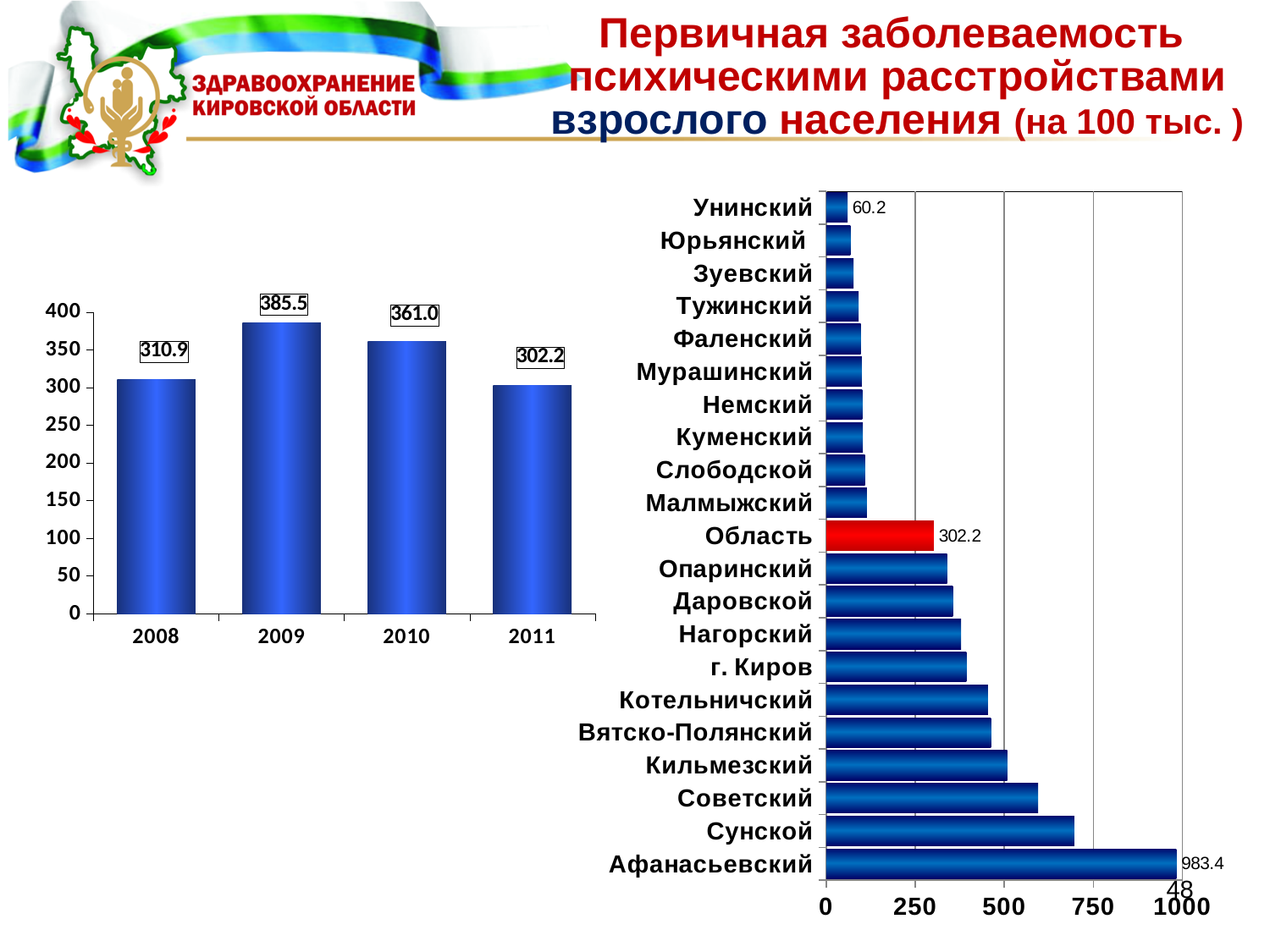
On the left chart, which year has the highest value? 2009 On the right chart, what is the value for Афанасьевский? 983.4 On the left chart, which is larger, the value for 2010 or the value for 2008? 2010 On the left chart, what is the value for 2009? 385.5 On the left chart, how many years are shown? 4 On the left chart, what is the difference between the values for 2009 and 2008? 74.6 On the right chart, is the value for Сунской greater or less than 500? greater On the left chart, what is the value for 2011? 302.2 On the left chart, which year has the lowest value? 2011 What type of chart is the right chart? bar chart On the right chart, which district has the highest value? Афанасьевский On the right chart, what is the value for Унинский? 60.2